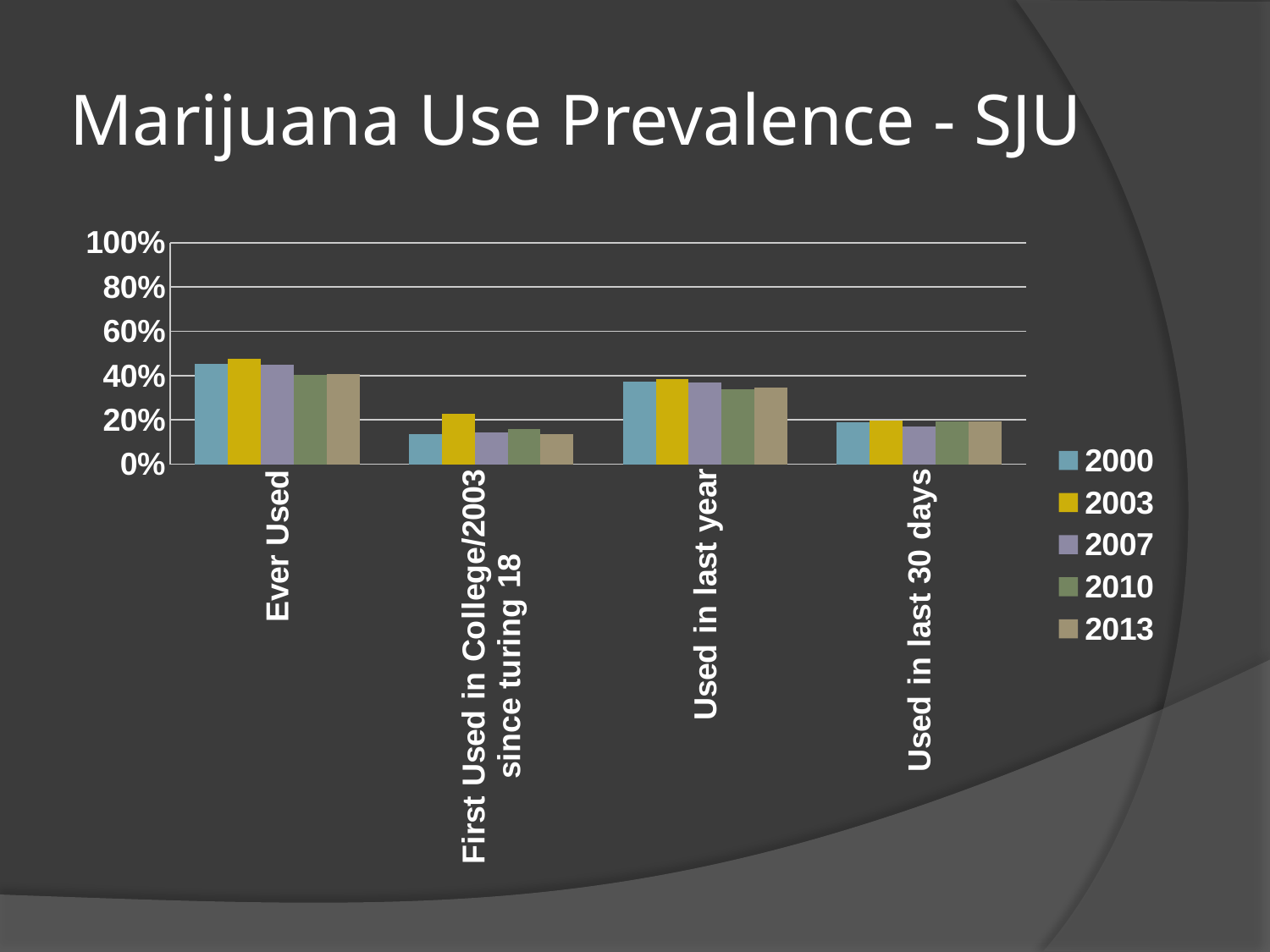
Which category has the highest bars overall? Ever Used In the 'First Used in College/2003 since turing 18' category, which is larger: the 2003 value or the 2010 value? 2003 What is the title of the slide? Marijuana Use Prevalence - SJU Which years are listed in the legend? 2000, 2003, 2007, 2010, 2013 How many series does the legend list? 5 How many categories are shown on the x axis? 4 Is the value for 2000 in the 'Ever Used' category greater or less than 40%? greater Is the value for 2000 in the 'Used in last year' category greater or less than 40%? less Which is larger for 2000: the 'Ever Used' value or the 'Used in last year' value? Ever Used Is the value for 2000 in the 'First Used in College/2003 since turing 18' category greater or less than 20%? less What kind of chart is shown on the slide? Bar chart Within the 'First Used in College/2003 since turing 18' category, which year has the highest bar? 2003